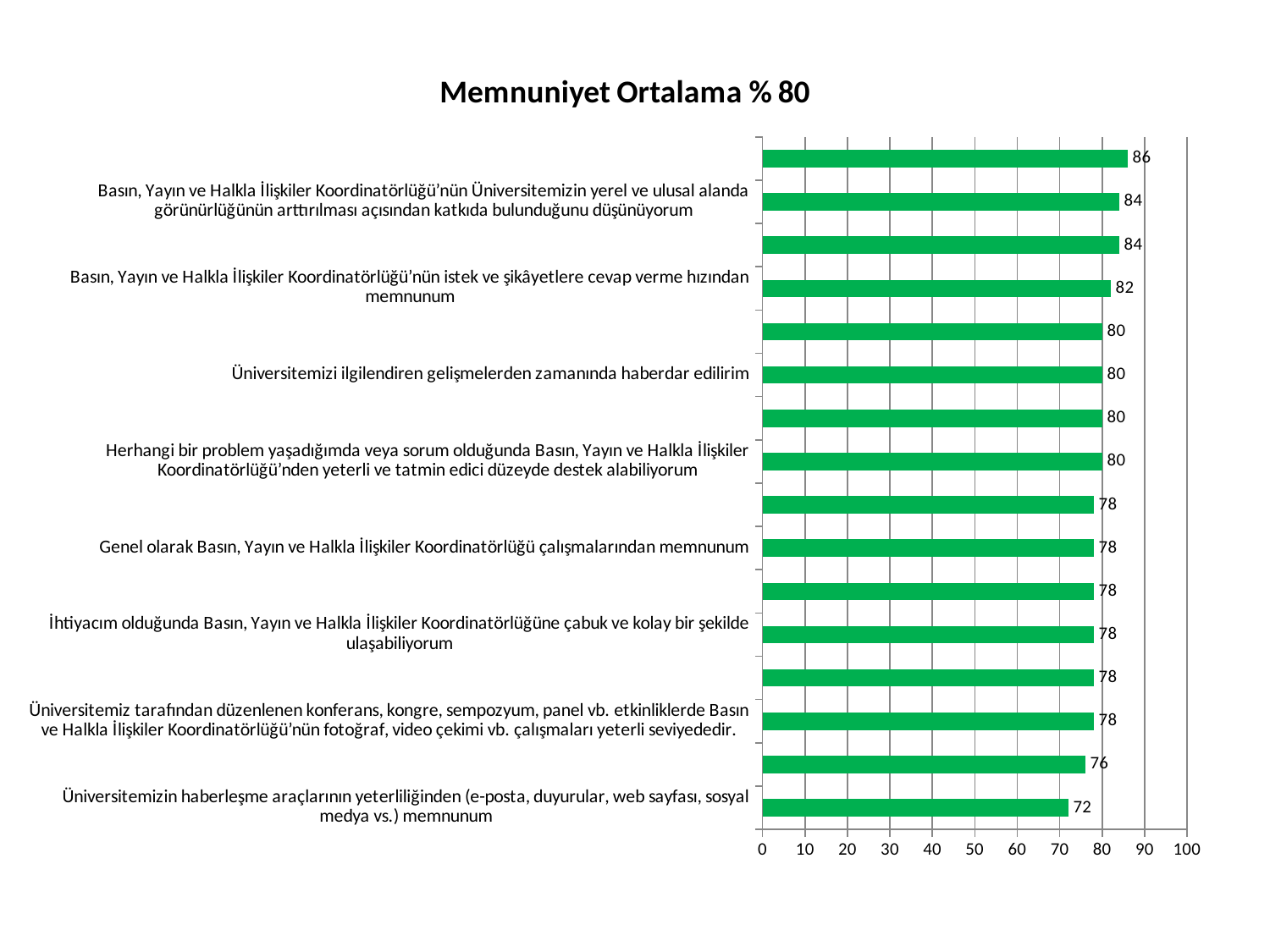
What is the value for "Genel olarak Basın, Yayın ve Halkla İlişkiler Koordinatörlüğü çalışmalarından memnunum"? 78 Is the value for "Üniversitemizin haberleşme araçlarının yeterliliğinden (e-posta, duyurular, web sayfası, sosyal medya vs.) memnunum" greater or less than 80? less What is the value for "Üniversitemizi ilgilendiren gelişmelerden zamanında haberdar edilirim"? 80 What is the value for "Üniversitemizin haberleşme araçlarının yeterliliğinden (e-posta, duyurular, web sayfası, sosyal medya vs.) memnunum"? 72 What is the title of the chart? Memnuniyet Ortalama % 80 What is the highest value shown in the chart? 86 How many bars are plotted in the chart? 16 Do the bar values increase or decrease going from the top of the chart to the bottom? decrease What kind of chart is shown on the slide? bar chart What is the difference between the highest value (86) and the lowest value (72) in the chart? 14 What is the value for "Basın, Yayın ve Halkla İlişkiler Koordinatörlüğü'nün istek ve şikâyetlere cevap verme hızından memnunum"? 82 What is the lowest value shown in the chart? 72